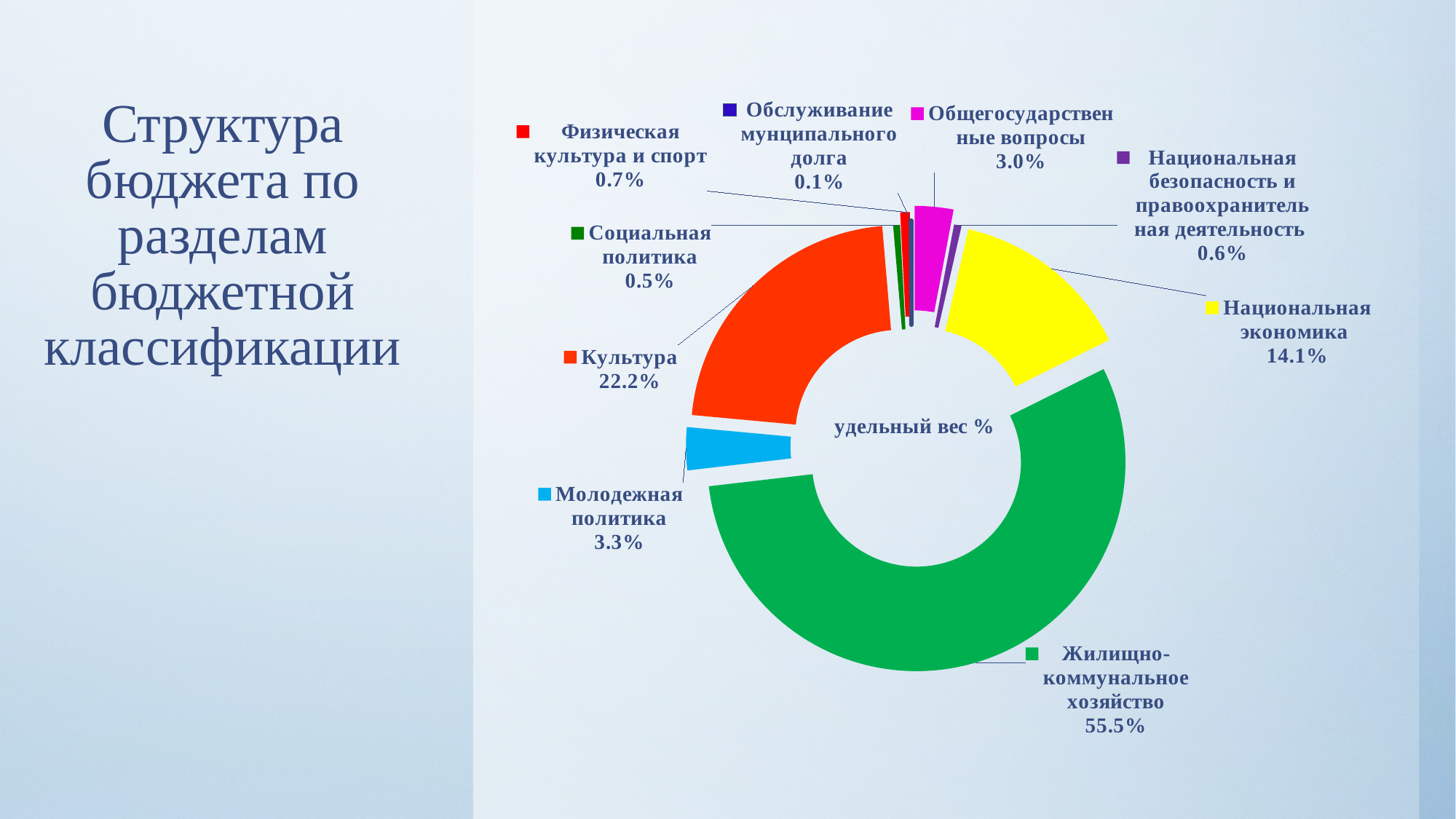
What share does Жилищно-коммунальное хозяйство have in the chart? 55.5% What is the value shown for Молодежная политика? 3.3% What is the value shown for Обслуживание муниципального долга? 0.1% What is the difference between the shares of Культура and Национальная экономика? 8.1% How many categories are shown in the chart? 9 Which is larger, the share of Общегосударственные вопросы or the share of Молодежная политика? Молодежная политика What is the value shown for Национальная экономика? 14.1% What is the value shown for Культура? 22.2% Which category has the smallest share in the chart? Обслуживание муниципального долга What kind of chart is shown on the slide? Doughnut (pie) chart Which category has the largest share in the chart? Жилищно-коммунальное хозяйство What text is shown in the centre of the chart? удельный вес %